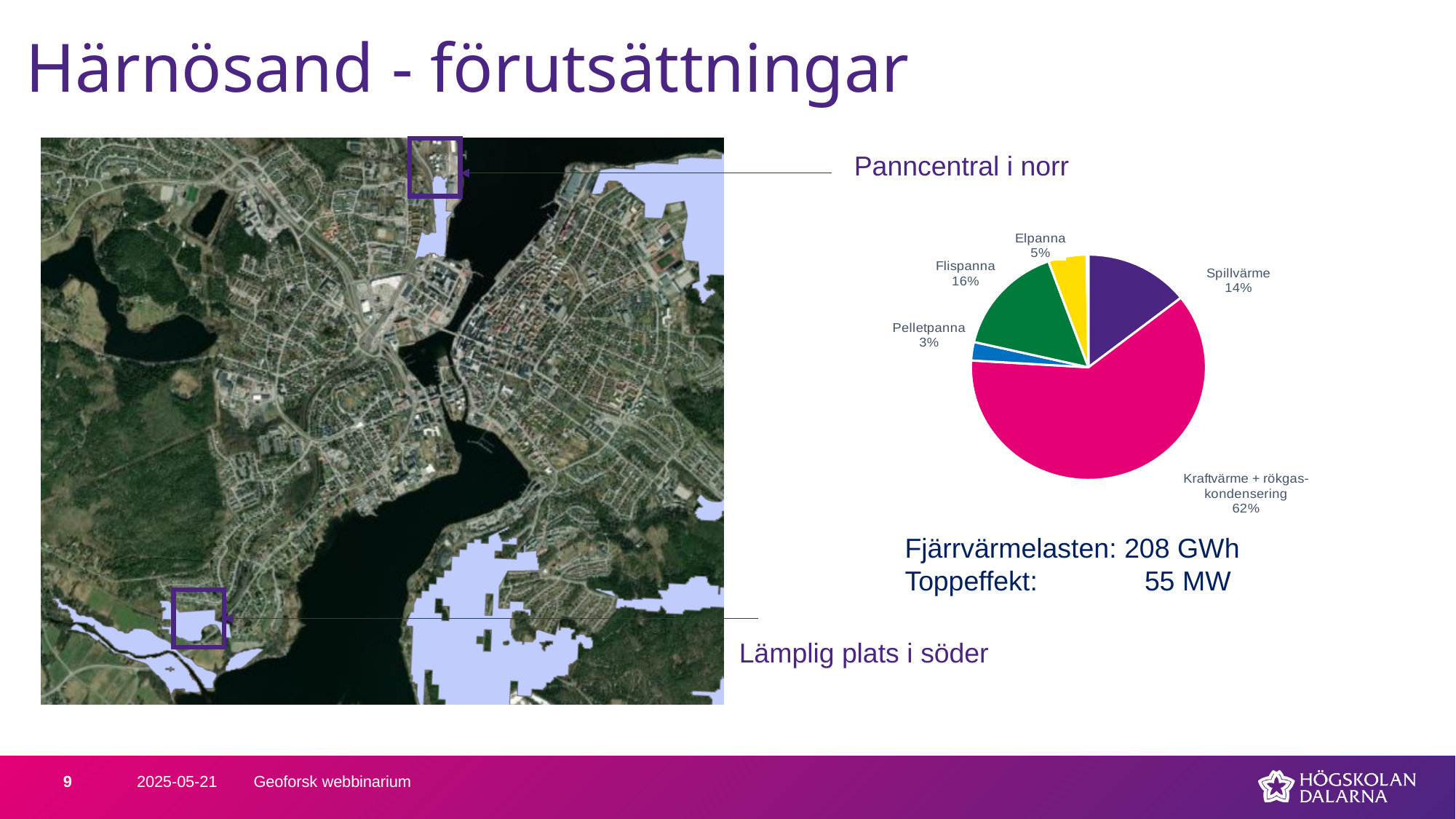
Which slice of the pie chart is the largest? Kraftvärme + rökgaskondensering What share of the pie chart is Kraftvärme + rökgaskondensering? 62% Which is larger in the pie chart, Flispanna or Spillvärme? Flispanna What kind of chart is shown on the slide? pie chart What share of the pie chart is Elpanna? 5% What share of the pie chart is Flispanna? 16% How many slices does the pie chart have? 5 Which slice of the pie chart is the smallest? Pelletpanna What is the difference in percentage points between Flispanna and Elpanna in the pie chart? 11 What colour is the Kraftvärme + rökgaskondensering slice in the pie chart? magenta